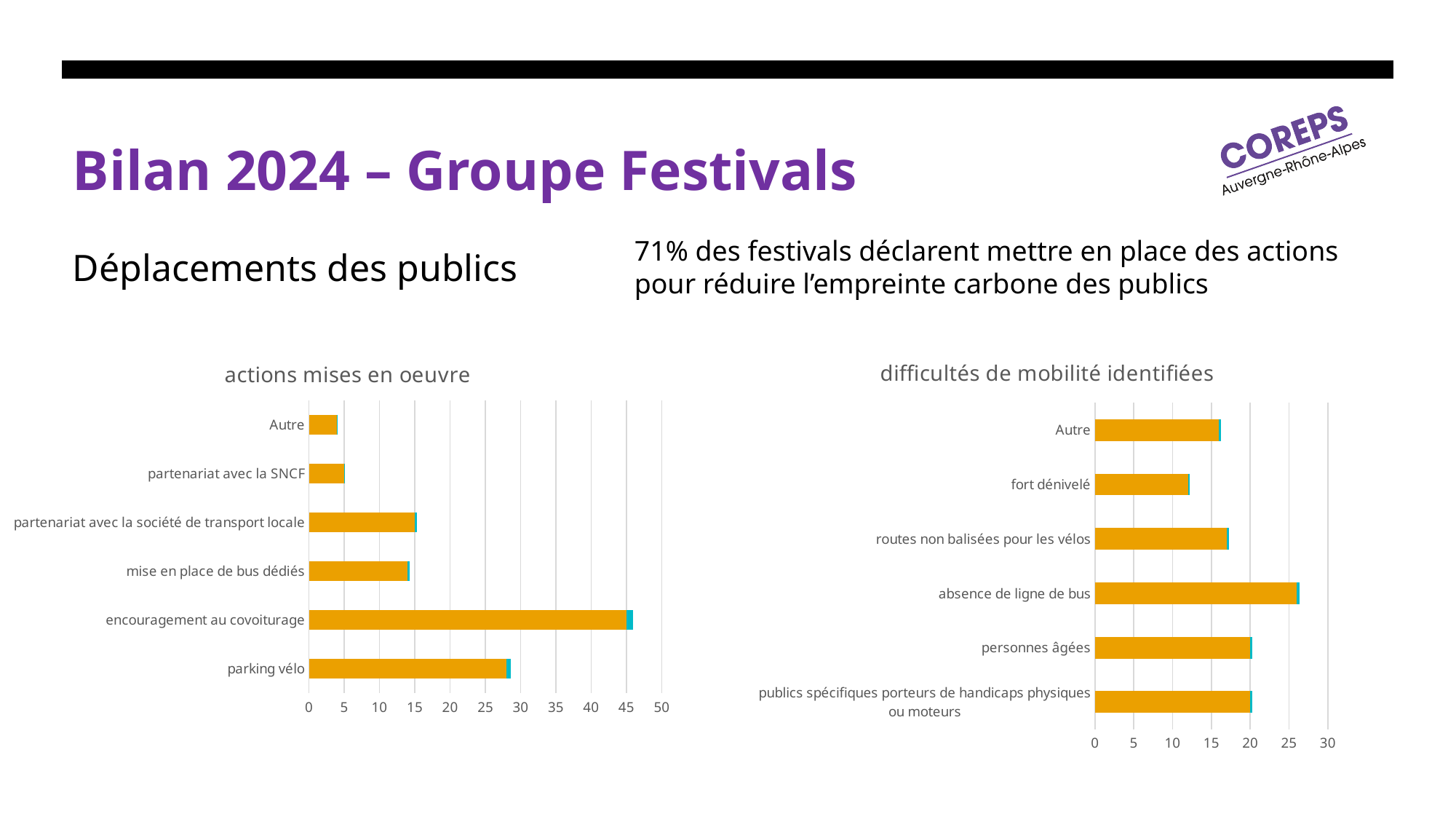
In the chart titled "actions mises en oeuvre", is the value for "encouragement au covoiturage" greater or less than 40? greater In the chart titled "difficultés de mobilité identifiées", which category has the lowest value? fort dénivelé In the chart titled "actions mises en oeuvre", which category has the highest value? encouragement au covoiturage In the chart titled "actions mises en oeuvre", is the value for "parking vélo" greater or less than 25? greater In the chart titled "difficultés de mobilité identifiées", which is larger: "routes non balisées pour les vélos" or "fort dénivelé"? routes non balisées pour les vélos In the chart titled "actions mises en oeuvre", which is larger: "parking vélo" or "mise en place de bus dédiés"? parking vélo In the chart titled "actions mises en oeuvre", is the value for "Autre" greater or less than 10? less What type of chart is the chart titled "difficultés de mobilité identifiées"? bar chart How many categories are shown in the chart titled "actions mises en oeuvre"? 6 In the chart titled "difficultés de mobilité identifiées", which category has the highest value? absence de ligne de bus